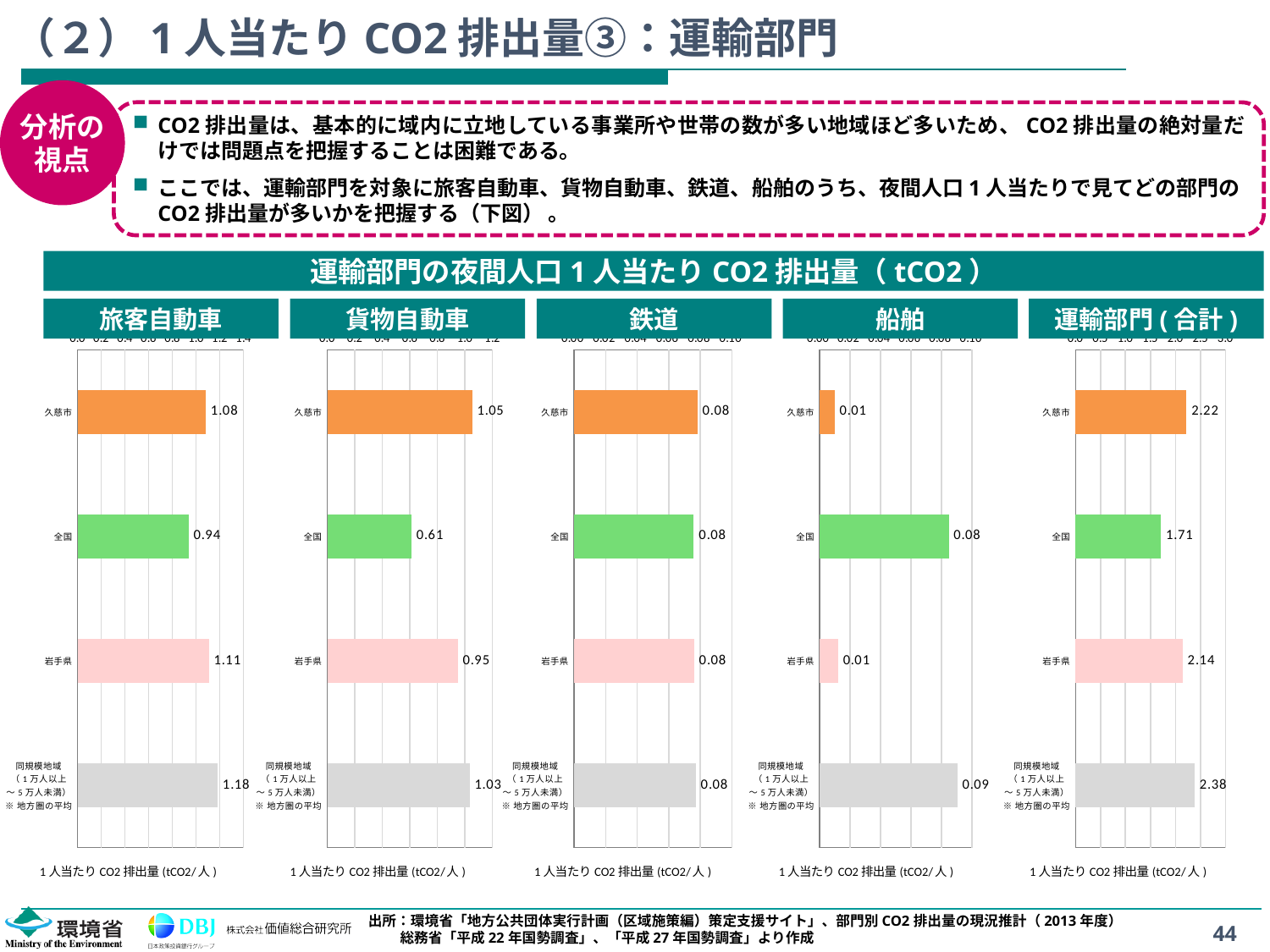
In the 旅客自動車 chart, which is larger, the value for 岩手県 or the value for 全国? 岩手県 How many charts are shown on the slide? 5 In the 旅客自動車 chart, what is the value for 久慈市? 1.08 How many categories are shown in the 鉄道 chart? 4 In the 運輸部門(合計) chart, what is the difference between the values for 久慈市 and 全国? 0.51 In the 船舶 chart, which category has the highest value? 同規模地域 In the 貨物自動車 chart, what is the value for 全国? 0.61 In the 貨物自動車 chart, which category has the lowest value? 全国 What kind of chart is the 船舶 chart? bar chart In the 運輸部門(合計) chart, is the value for 同規模地域 greater or less than 2.0? greater In the 船舶 chart, what is the value for 岩手県? 0.01 In the 運輸部門(合計) chart, which category has the highest value? 同規模地域